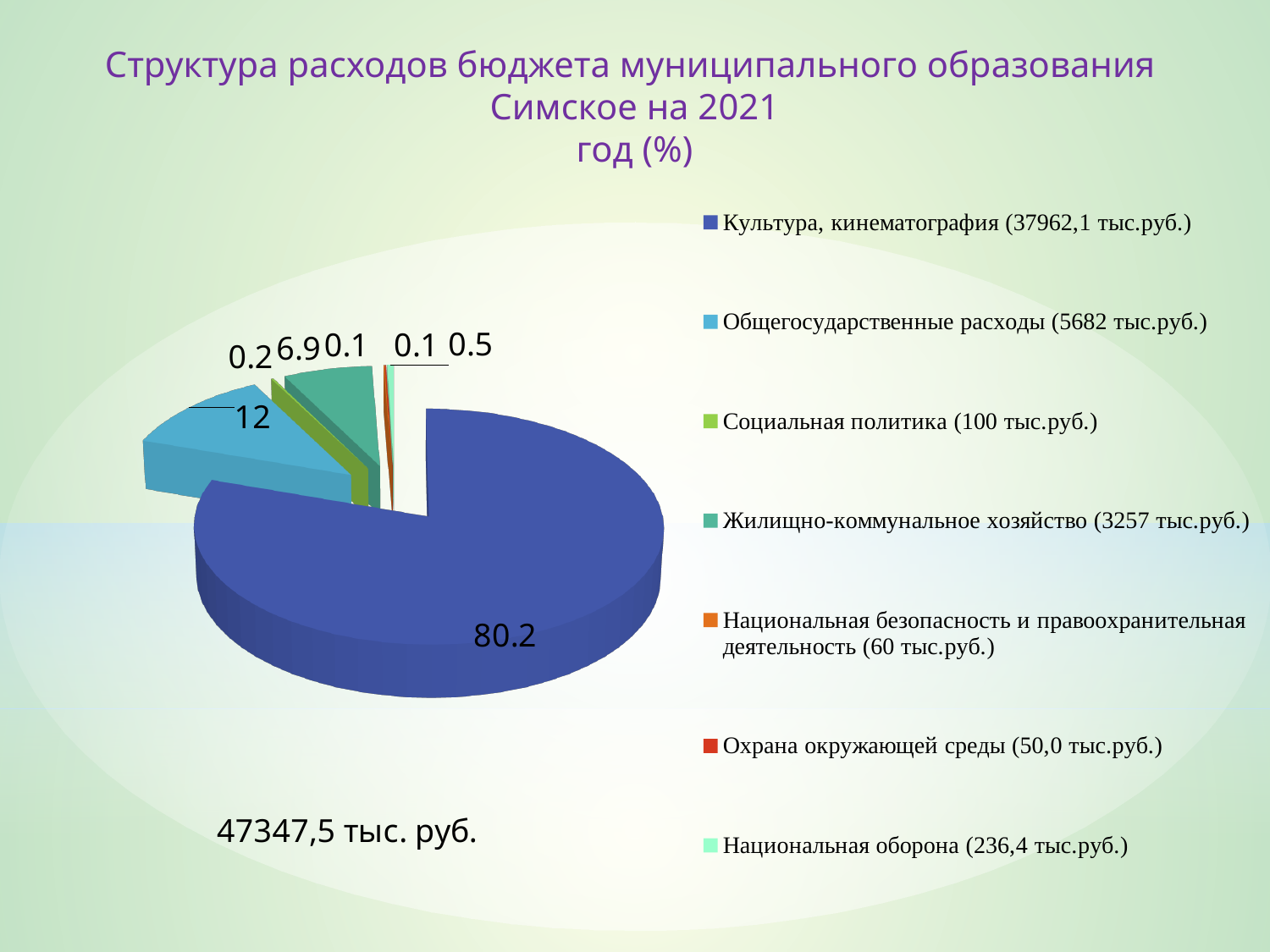
What percentage share does Общегосударственные расходы have in the pie chart? 12 What percentage share does Жилищно-коммунальное хозяйство have in the pie chart? 6.9 What percentage share does Социальная политика have in the pie chart? 0.2 What amount in thousand rubles does the legend give for Жилищно-коммунальное хозяйство? 3257 тыс.руб. Which has a larger share: Общегосударственные расходы or Жилищно-коммунальное хозяйство? Общегосударственные расходы How many categories does the legend of the pie chart list? 7 What percentage share does Национальная оборона have in the pie chart? 0.5 What total budget amount in thousand rubles is printed below the pie chart? 47347,5 тыс. руб. What is the difference in percentage points between the shares of Культура, кинематография and Общегосударственные расходы? 68.2 Which category has the largest share of the pie chart? Культура, кинематография What type of chart is shown on the slide? pie chart What percentage share does Культура, кинематография have in the pie chart? 80.2